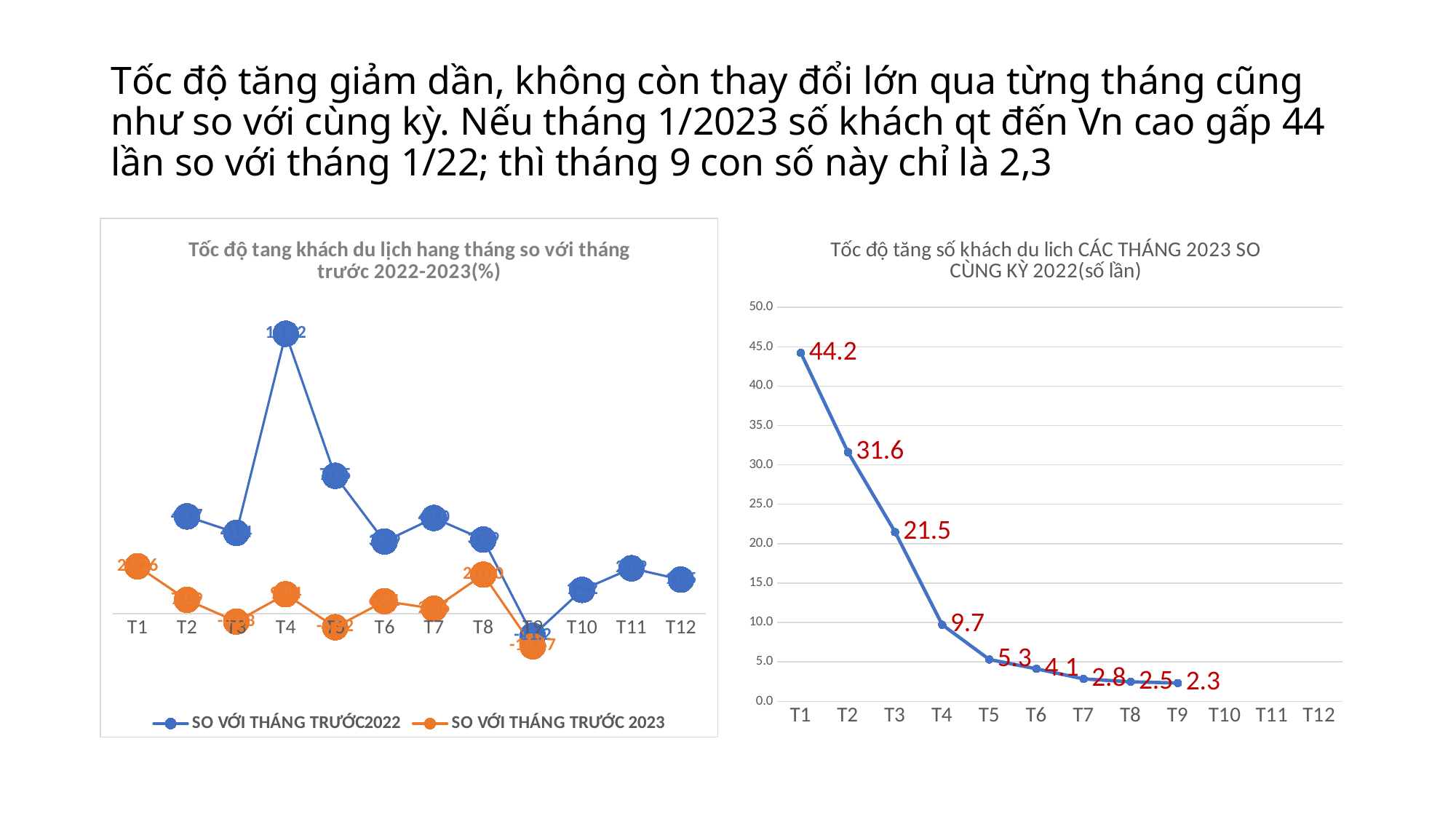
On the right chart, what is the value for T4? 9.7 On the right chart, which month with a plotted value has the lowest value? T9 What kind of chart is the right chart? line chart On the right chart, which is larger, the value for T3 or the value for T5? T3 On the right chart, do the values rise or fall from T1 to T9? fall On the right chart, how many months have a plotted data point? 9 On the right chart, what is the difference between the values for T1 and T2? 12.6 On the left chart, in which month does the series 'SO VỚI THÁNG TRƯỚC2022' reach its highest value? T4 On the right chart (Tốc độ tăng số khách du lịch CÁC THÁNG 2023 SO CÙNG KỲ 2022), what is the value for T1? 44.2 On the left chart (Tốc độ tang khách du lịch hang tháng so với tháng trước 2022-2023), how many series does the legend list? 2 On the right chart, which month has the highest value? T1 On the right chart, what is the value for T9? 2.3